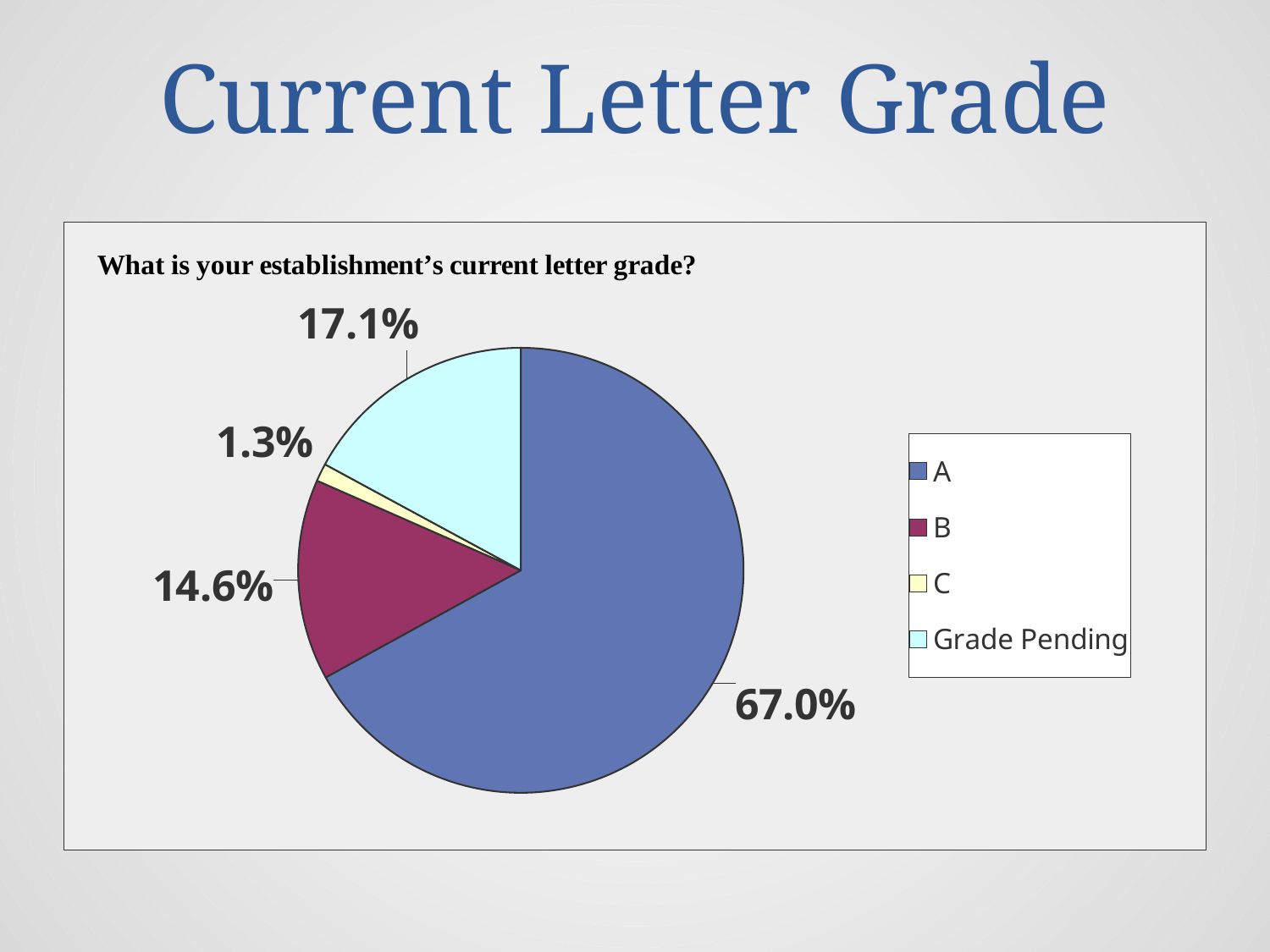
What percentage of establishments have a current letter grade of C? 1.3% What percentage of establishments have a current letter grade of B? 14.6% What type of chart is shown on the slide? pie chart Which is larger, the share for B or the share for Grade Pending? Grade Pending How many categories does the pie chart show? 4 What is the difference in percentage points between the A share and the Grade Pending share? 49.9 Which letter grade category has the largest share of the pie? A What percentage of establishments have a current letter grade of A? 67.0% Which category has the smallest share of the pie? C What question is shown as the chart's title? What is your establishment's current letter grade? What colour is the slice for Grade Pending? light cyan What percentage of establishments have a Grade Pending? 17.1%